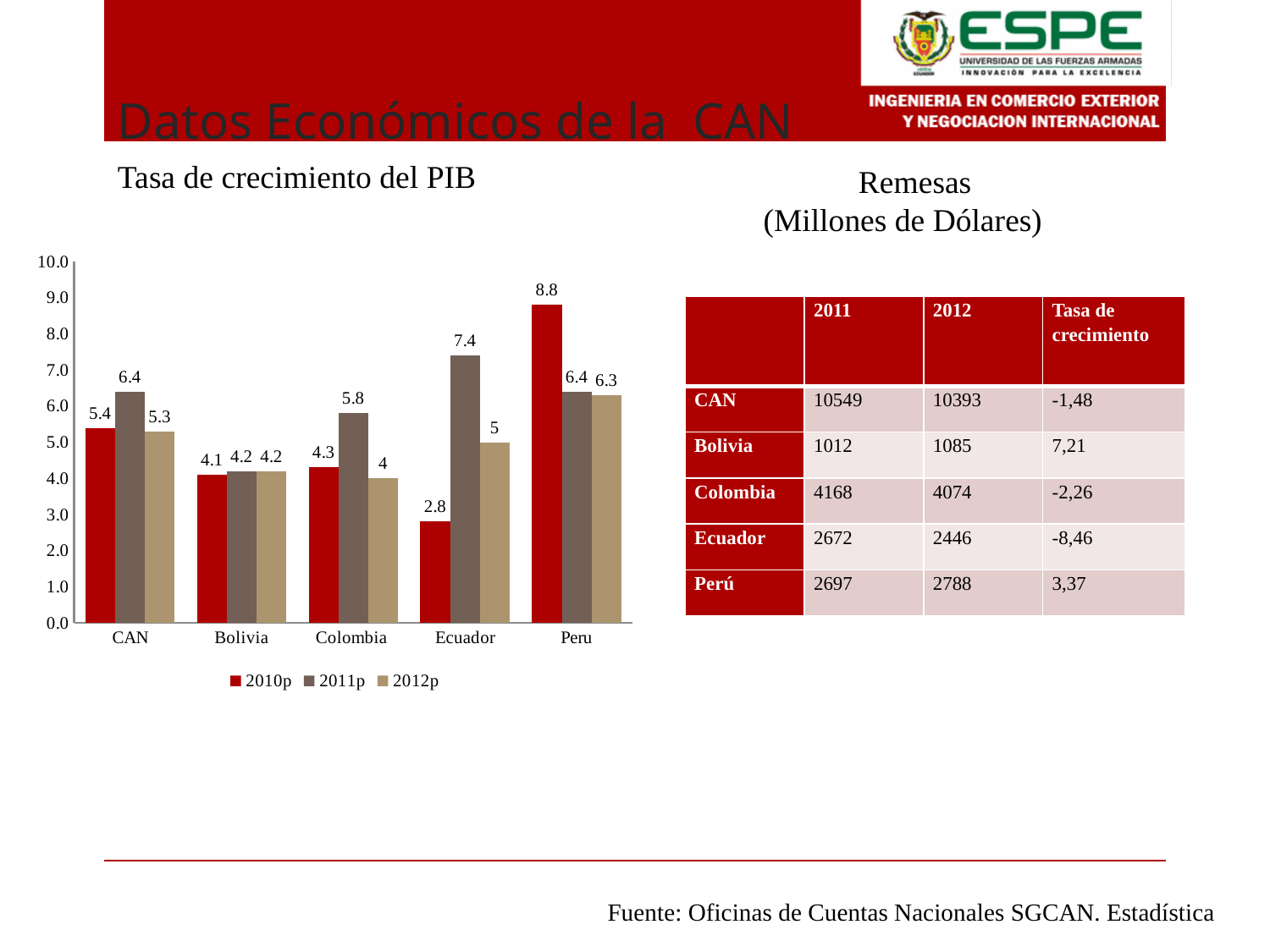
In the "Tasa de crecimiento del PIB" chart, is the 2010p value for Peru greater or less than 8.0? greater In the "Tasa de crecimiento del PIB" chart, which series is shown in red? 2010p What type of chart is shown under the title "Tasa de crecimiento del PIB"? bar chart In the "Tasa de crecimiento del PIB" chart, which country has the highest value in the 2010p series? Peru In the "Tasa de crecimiento del PIB" chart, which is larger: the 2011p value for CAN or the 2011p value for Colombia? CAN How many countries or groups are shown on the x axis of the "Tasa de crecimiento del PIB" chart? 5 In the "Tasa de crecimiento del PIB" chart, what is the value for Ecuador in the 2011p series? 7.4 In the "Tasa de crecimiento del PIB" chart, what is the difference between the 2011p and 2010p values for Ecuador? 4.6 In the "Tasa de crecimiento del PIB" chart, what is the value for Colombia in the 2012p series? 4 In the "Tasa de crecimiento del PIB" chart, what is the value for Peru in the 2010p series? 8.8 How many series does the legend of the "Tasa de crecimiento del PIB" chart list? 3 In the "Tasa de crecimiento del PIB" chart, which country has the lowest value in the 2010p series? Ecuador